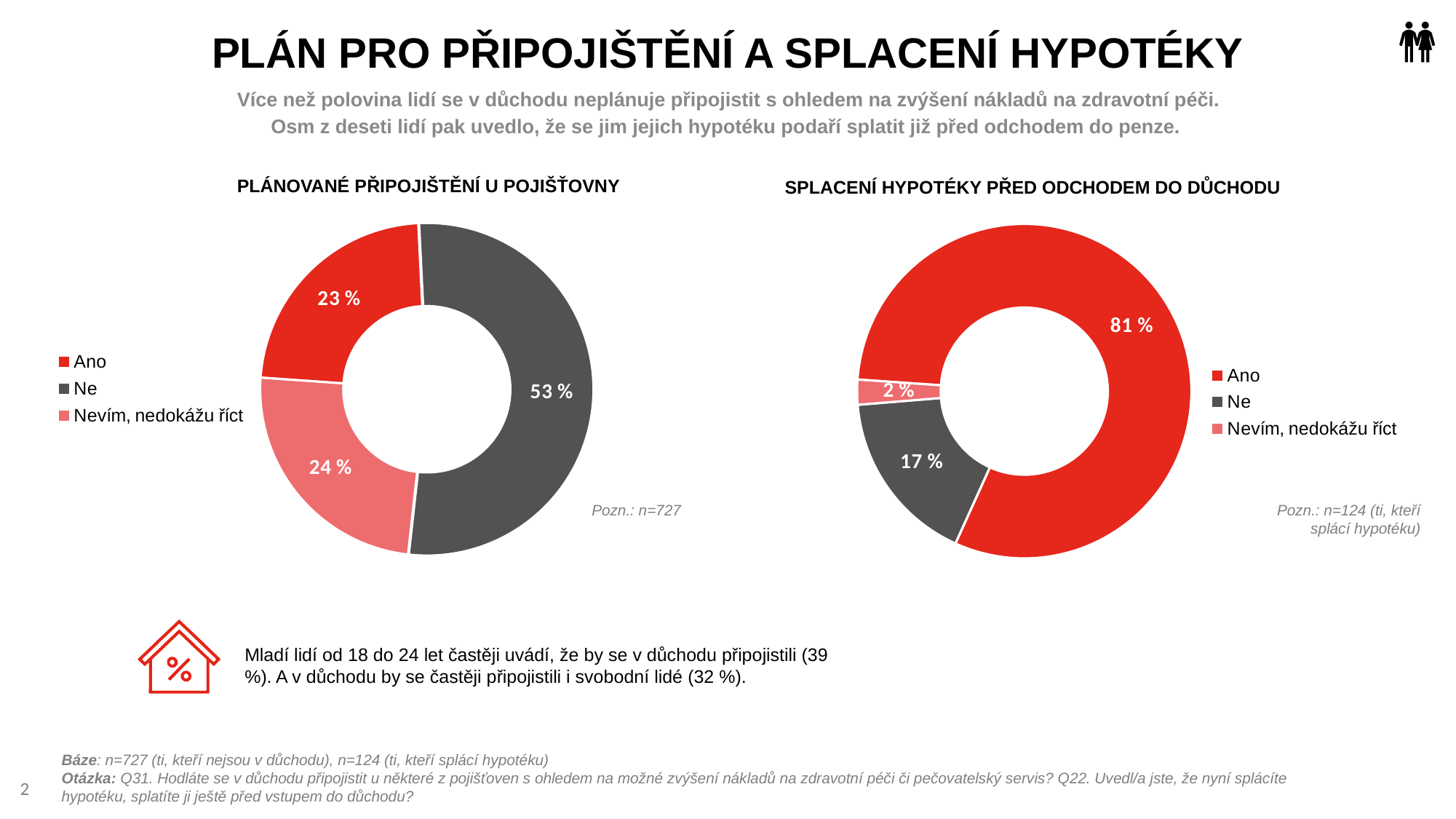
In the chart titled 'PLÁNOVANÉ PŘIPOJIŠTĚNÍ U POJIŠŤOVNY', which category has the largest share? Ne In the chart titled 'PLÁNOVANÉ PŘIPOJIŠTĚNÍ U POJIŠŤOVNY', what is the value for 'Ano'? 23 % In the chart titled 'PLÁNOVANÉ PŘIPOJIŠTĚNÍ U POJIŠŤOVNY', what is the difference between 'Ne' and 'Nevím, nedokážu říct'? 29 % How many categories does the chart titled 'PLÁNOVANÉ PŘIPOJIŠTĚNÍ U POJIŠŤOVNY' show? 3 In the chart titled 'SPLACENÍ HYPOTÉKY PŘED ODCHODEM DO DŮCHODU', what is the value for 'Nevím, nedokážu říct'? 2 % In the chart titled 'SPLACENÍ HYPOTÉKY PŘED ODCHODEM DO DŮCHODU', which is larger, 'Ne' or 'Nevím, nedokážu říct'? Ne In the chart titled 'SPLACENÍ HYPOTÉKY PŘED ODCHODEM DO DŮCHODU', what is the difference between 'Ano' and 'Ne'? 64 % What kind of chart is the chart titled 'SPLACENÍ HYPOTÉKY PŘED ODCHODEM DO DŮCHODU'? Doughnut (pie) chart In the chart titled 'SPLACENÍ HYPOTÉKY PŘED ODCHODEM DO DŮCHODU', what is the value for 'Ano'? 81 % In the chart titled 'PLÁNOVANÉ PŘIPOJIŠTĚNÍ U POJIŠŤOVNY', what colour is the 'Ne' slice? Dark grey In the chart titled 'SPLACENÍ HYPOTÉKY PŘED ODCHODEM DO DŮCHODU', which category has the smallest share? Nevím, nedokážu říct In the chart titled 'PLÁNOVANÉ PŘIPOJIŠTĚNÍ U POJIŠŤOVNY', what is the value for 'Ne'? 53 %